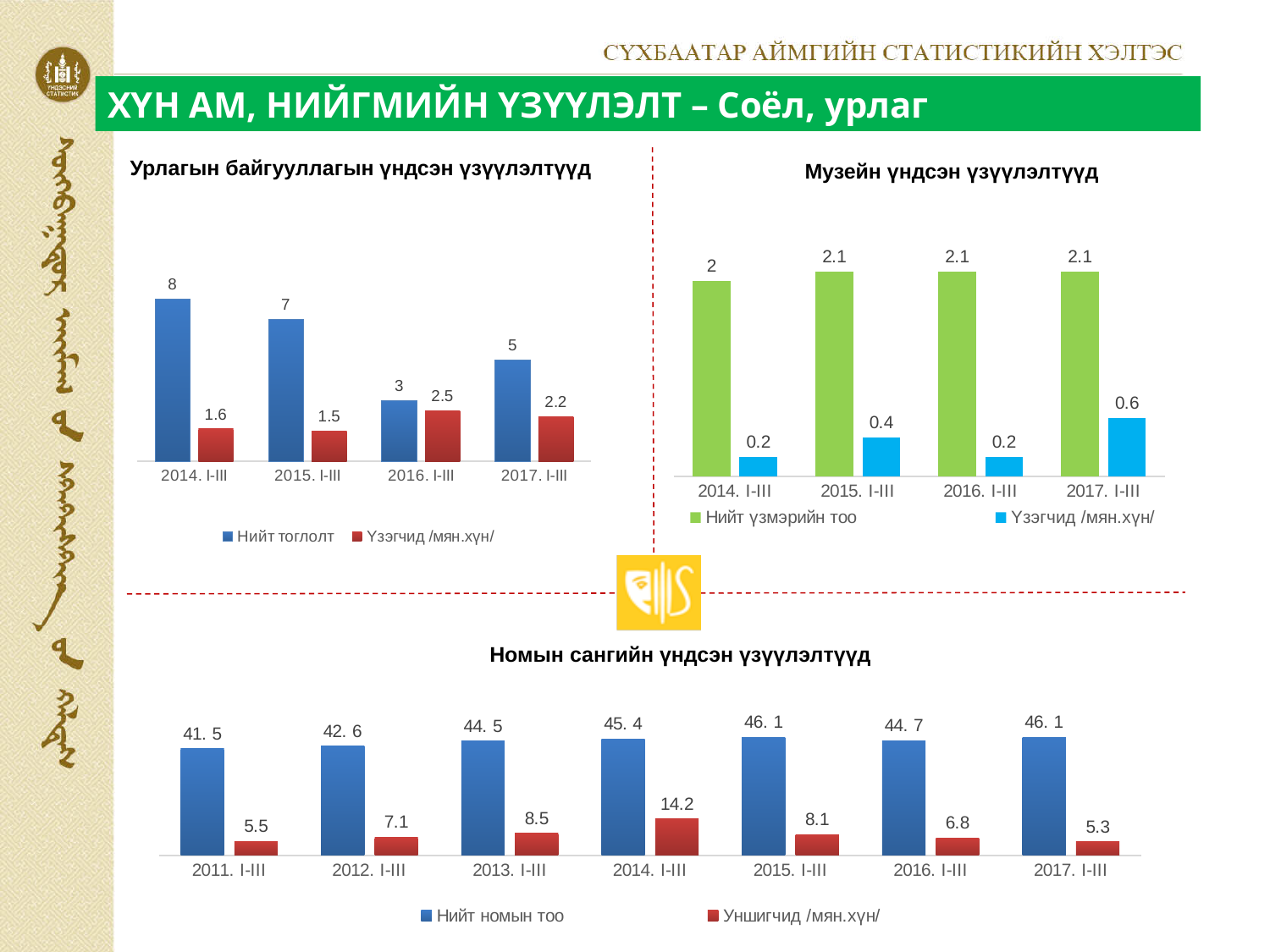
In the chart titled 'Музейн үндсэн үзүүлэлтүүд', what is the value of 'Нийт үзмэрийн тоо' for 2014. I-III? 2 In the chart titled 'Урлагын байгууллагын үндсэн үзүүлэлтүүд', what is the value of 'Нийт тоглолт' for 2014. I-III? 8 In the chart titled 'Музейн үндсэн үзүүлэлтүүд', which period has the highest value for 'Үзэгчид /мян.хүн/'? 2017. I-III In the chart titled 'Номын сангийн үндсэн үзүүлэлтүүд', what is the value of 'Уншигчид /мян.хүн/' for 2012. I-III? 7.1 In the chart titled 'Номын сангийн үндсэн үзүүлэлтүүд', how many periods are shown on the x axis? 7 In the chart titled 'Музейн үндсэн үзүүлэлтүүд', what kind of chart is shown? bar chart In the chart titled 'Урлагын байгууллагын үндсэн үзүүлэлтүүд', which period has the lowest value for 'Нийт тоглолт'? 2016. I-III In the chart titled 'Номын сангийн үндсэн үзүүлэлтүүд', is 'Уншигчид /мян.хүн/' larger in 2013. I-III or in 2016. I-III? 2013. I-III In the chart titled 'Урлагын байгууллагын үндсэн үзүүлэлтүүд', how many series does the legend list? 2 In the chart titled 'Музейн үндсэн үзүүлэлтүүд', what is the value of 'Үзэгчид /мян.хүн/' for 2017. I-III? 0.6 In the chart titled 'Урлагын байгууллагын үндсэн үзүүлэлтүүд', what is the difference between 'Нийт тоглолт' in 2014. I-III and 2015. I-III? 1 In the chart titled 'Номын сангийн үндсэн үзүүлэлтүүд', which period has the highest value for 'Уншигчид /мян.хүн/'? 2014. I-III